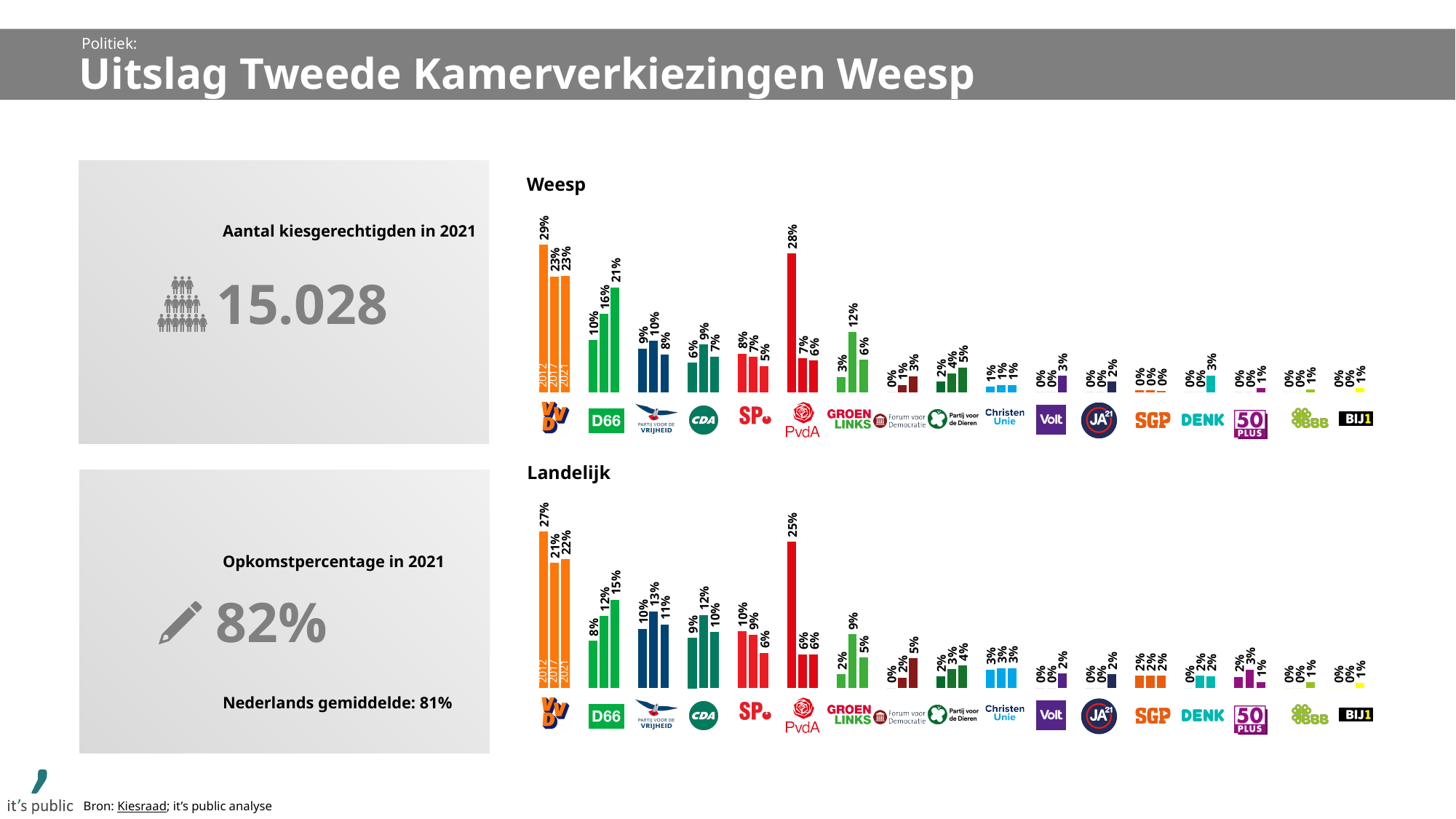
In the Landelijk chart, what percentage did PVV (Partij voor de Vrijheid) get in 2017? 13% In the Landelijk chart, do SP's values rise or fall from 2012 to 2021? fall What type of chart is the Landelijk chart? bar chart How many years (bars per party) are shown for each party in the Weesp chart? 3 In the Landelijk chart, what is the difference between D66's 2021 and 2012 percentages? 7% In the Landelijk chart, what percentage did PvdA get in 2012? 25% In the Weesp chart, what is the difference between PvdA's 2012 and 2017 percentages? 21% In the Weesp chart, what percentage did VVD get in 2012? 29% In the Weesp chart, which party had the highest percentage in 2021? VVD In the Weesp chart, what percentage did D66 get in 2021? 21% In the Weesp chart, which is larger: GroenLinks in 2017 or CDA in 2017? GroenLinks in 2017 In the Weesp chart, do D66's values rise or fall from 2012 to 2021? rise